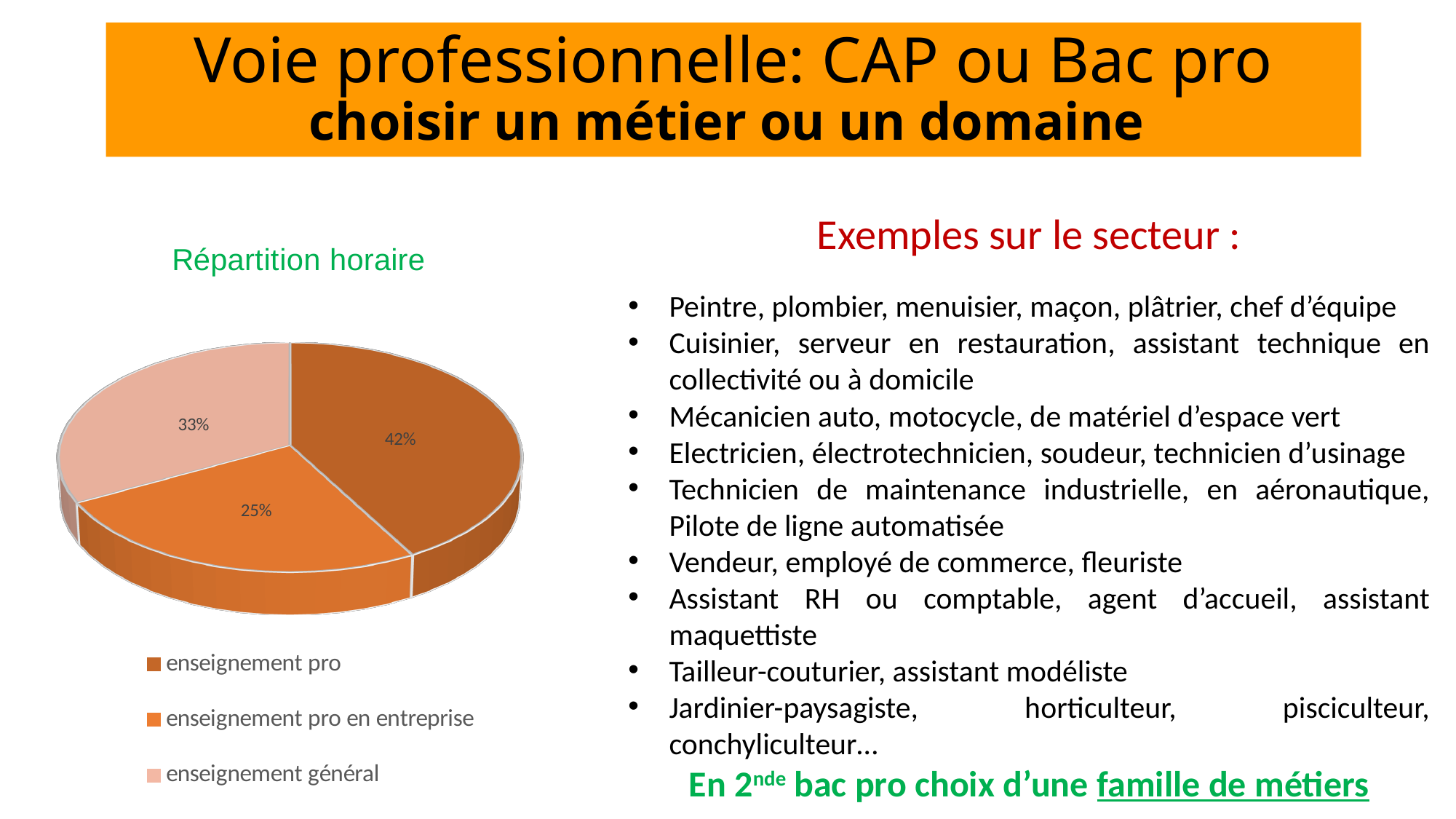
What is the difference in percentage points between 'enseignement général' and 'enseignement pro en entreprise'? 8 Which is larger: the share for 'enseignement général' or for 'enseignement pro en entreprise'? enseignement général What share of the pie does 'enseignement pro en entreprise' represent? 25% Which category has the smallest slice of the pie? enseignement pro en entreprise What share of the pie does 'enseignement général' represent? 33% What is the difference in percentage points between 'enseignement pro' and 'enseignement général'? 9 How many slices does the pie chart have? 3 What kind of chart is shown on the slide? pie chart Which category has the largest slice of the pie? enseignement pro What share of the pie does 'enseignement pro' represent? 42% What is the title of the chart? Répartition horaire Which legend entry is shown with the lightest colour? enseignement général